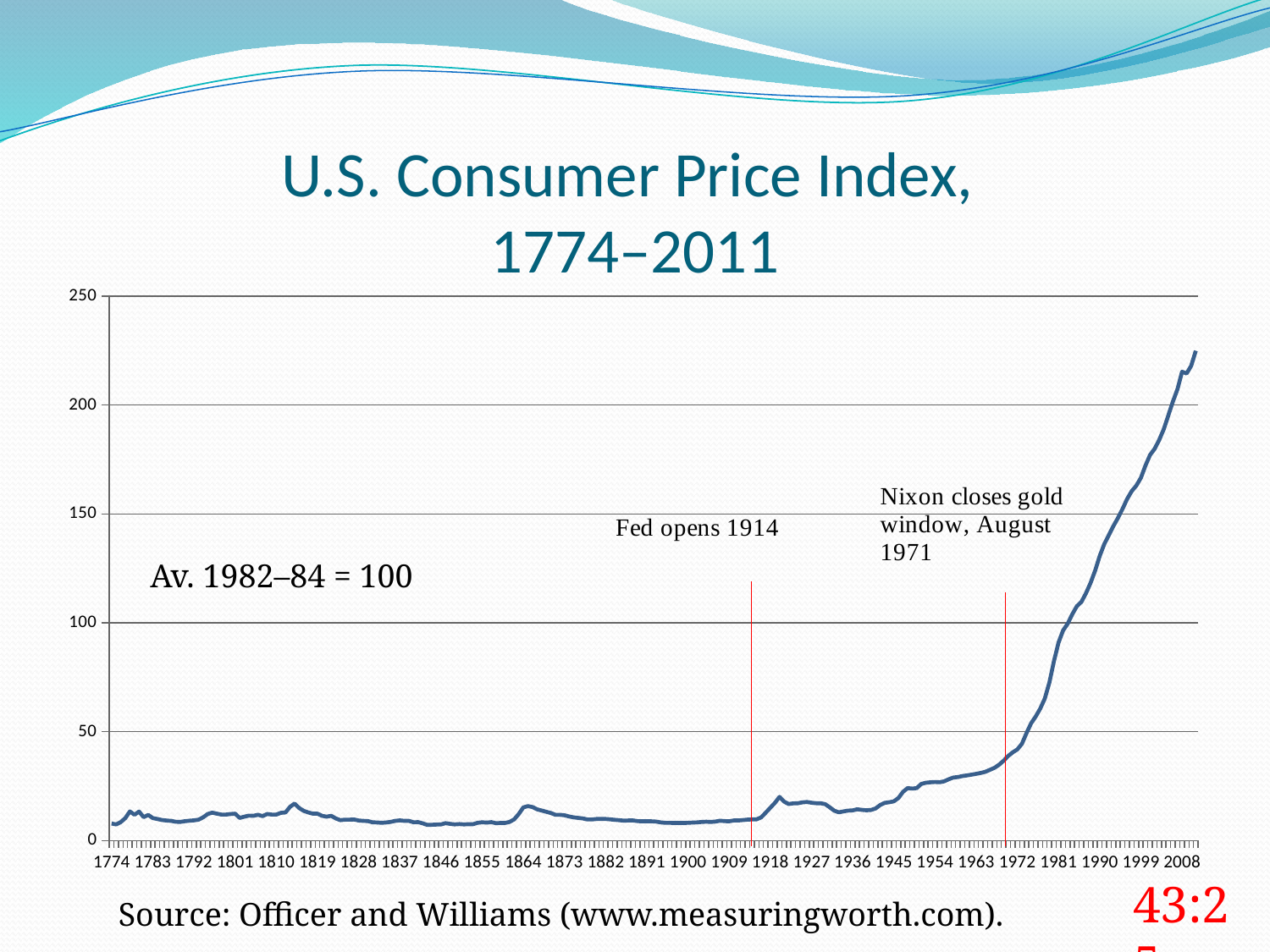
What base period is the index set to 100, according to the annotation on the chart? Av. 1982–84 = 100 Is the value of the Consumer Price Index in 1990 greater or less than 100? greater What kind of chart is shown on the slide? line chart How many year labels are shown on the x axis? 27 What is the title of the chart? U.S. Consumer Price Index, 1774–2011 Is the value of the Consumer Price Index in 1900 greater or less than 50? less Is the value of the Consumer Price Index in 1945 greater or less than 50? less Which year has the higher Consumer Price Index value, 1774 or 2008? 2008 Which year has the higher Consumer Price Index value, 1900 or 1918? 1918 Does the Consumer Price Index generally rise or fall from 1972 to 2011? rise